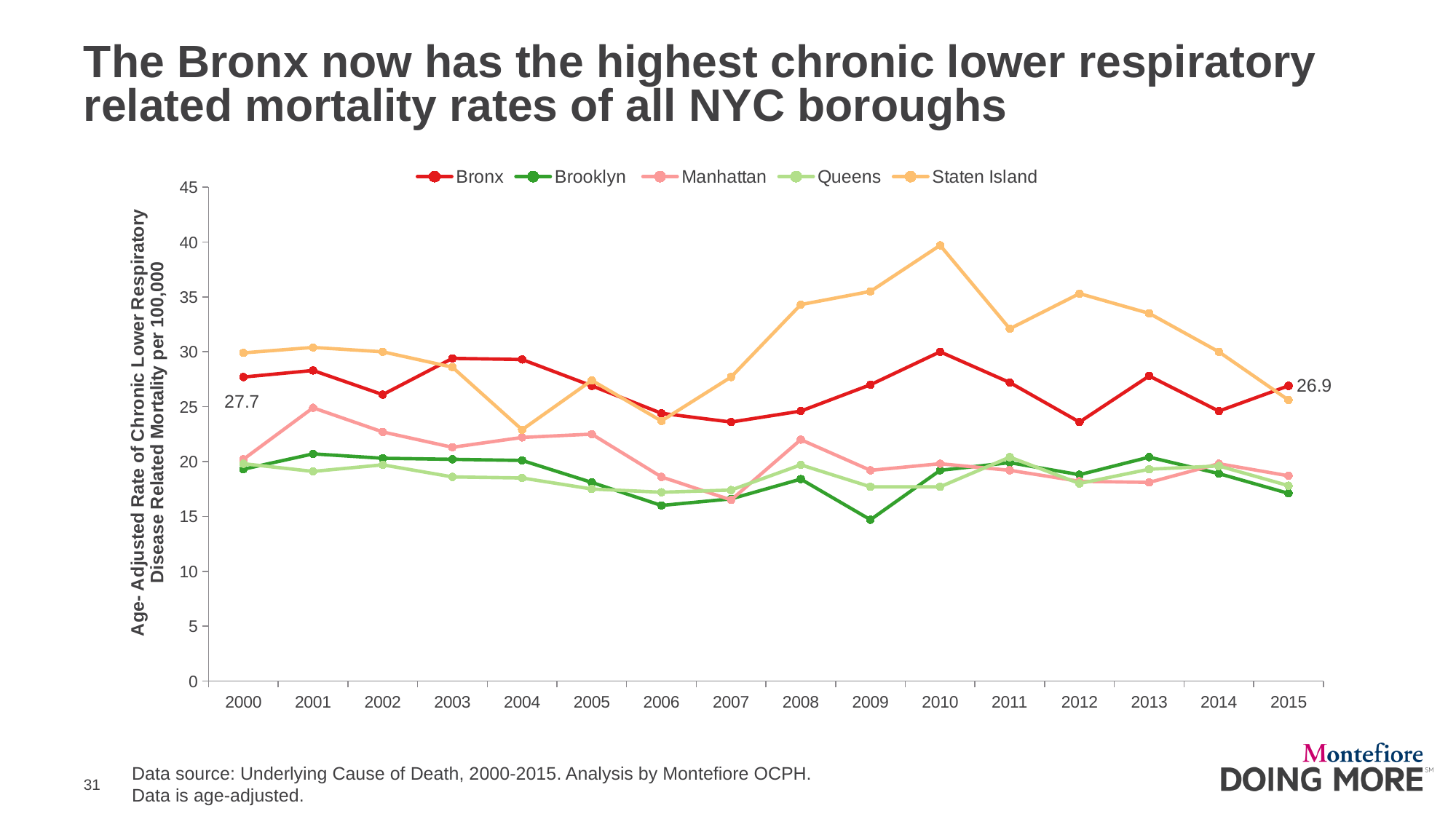
Does the Staten Island line rise or fall from 2012 to 2015? Falls What is the labelled value for the Bronx in 2000? 27.7 What kind of chart is shown on the slide? Line chart By how much did the Bronx value change between 2000 (27.7) and 2015 (26.9)? 0.8 Which borough has the highest value in 2010? Staten Island Is the value for Staten Island in 2010 greater or less than 35? greater What is the labelled value for the Bronx in 2015? 26.9 In 2004, which is larger: the value for the Bronx or the value for Staten Island? Bronx How many years are shown on the x axis? 16 How many series does the legend list? 5 Is the value for Brooklyn in 2006 greater or less than 20? less Which borough has the lowest value in 2009? Brooklyn